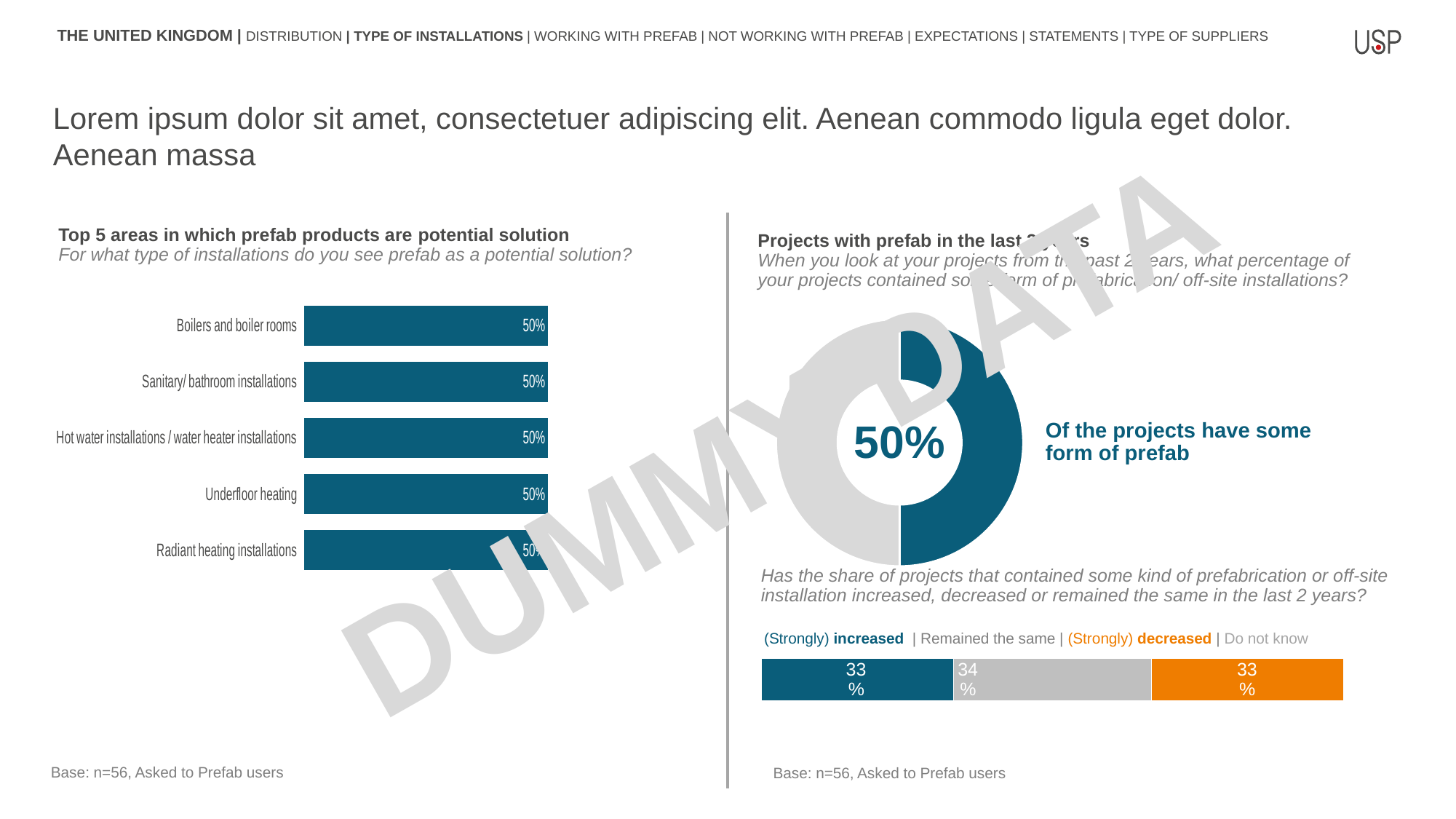
How many categories are shown in the 'Top 5 areas in which prefab products are potential solution' chart? 5 What kind of chart is used on the right side of the slide to show the share of projects with some form of prefab? Donut chart In the stacked bar at the bottom right of the slide, what is the value for (Strongly) increased? 33% What kind of chart is the 'Top 5 areas in which prefab products are potential solution' chart? Bar chart In the 'Top 5 areas in which prefab products are potential solution' chart, what is the value for Radiant heating installations? 50% In the stacked bar at the bottom right of the slide, which is larger: Remained the same or (Strongly) decreased? Remained the same In the 'Top 5 areas in which prefab products are potential solution' chart, what is the value for Boilers and boiler rooms? 50% In the stacked bar at the bottom right of the slide, what is the total of the three printed segments? 100% In the donut chart on the right side of the slide, what percentage of projects have some form of prefab? 50% In the 'Top 5 areas in which prefab products are potential solution' chart, what is the value for Underfloor heating? 50% In the stacked bar at the bottom right of the slide, what is the value for Remained the same? 34% In the 'Top 5 areas in which prefab products are potential solution' chart, what is the difference between the values for Sanitary/ bathroom installations and Hot water installations / water heater installations? 0%